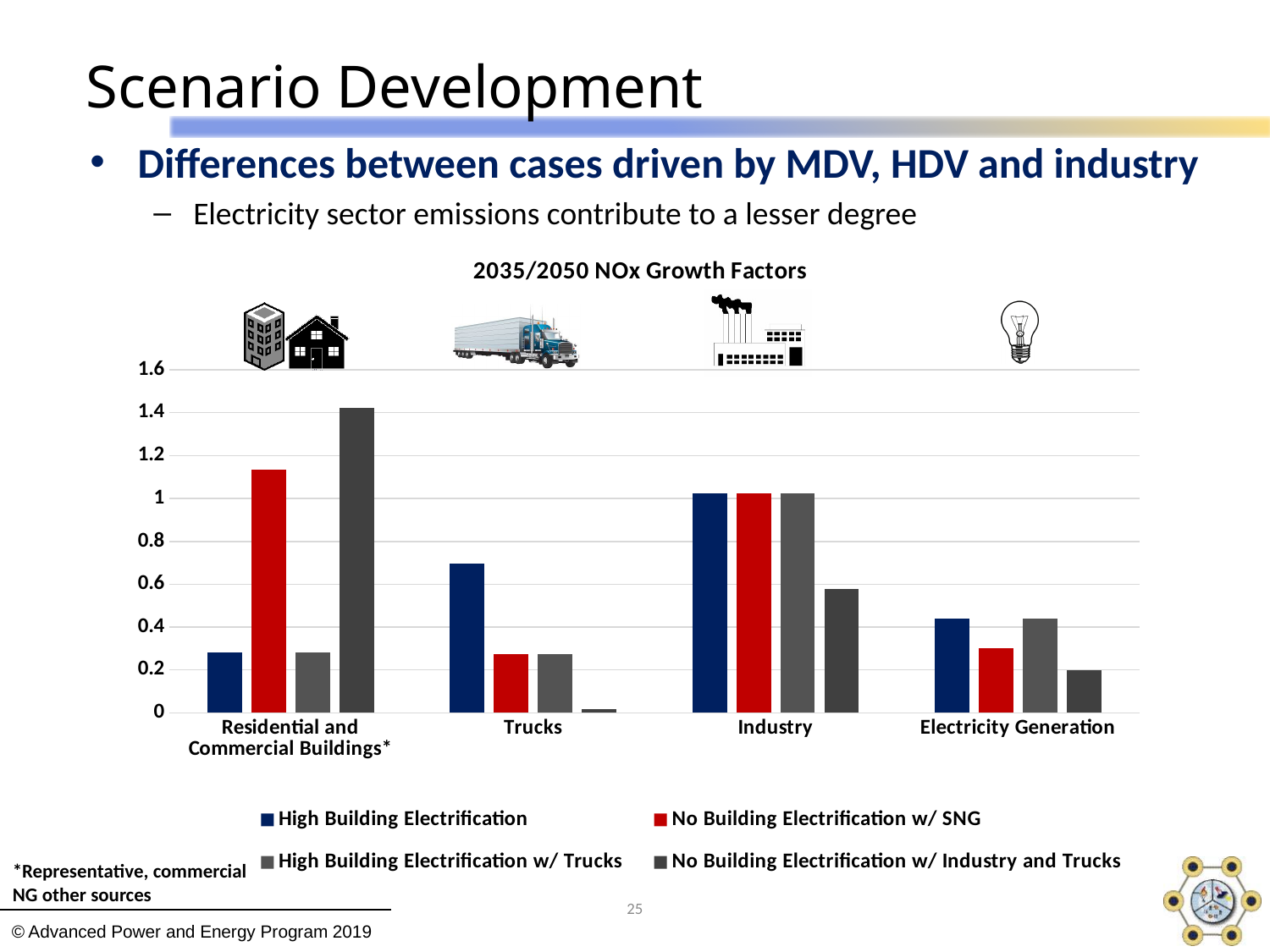
How many categories are shown on the x axis of the chart? 4 What is the title of the chart? 2035/2050 NOx Growth Factors Is the value for No Building Electrification w/ Industry and Trucks in Residential and Commercial Buildings* greater or less than 1.2? greater Is the value for No Building Electrification w/ SNG in Electricity Generation greater or less than 0.4? less Which series is shown in red in the chart's legend? No Building Electrification w/ SNG Which category has the highest value for the No Building Electrification w/ Industry and Trucks series? Residential and Commercial Buildings* Which category has the lowest value for the No Building Electrification w/ Industry and Trucks series? Trucks In the Residential and Commercial Buildings* category, which is larger: the No Building Electrification w/ SNG value or the High Building Electrification value? No Building Electrification w/ SNG How many series does the chart's legend list? 4 What kind of chart is shown on the slide? bar chart Is the value for No Building Electrification w/ Industry and Trucks in Industry greater or less than 0.8? less